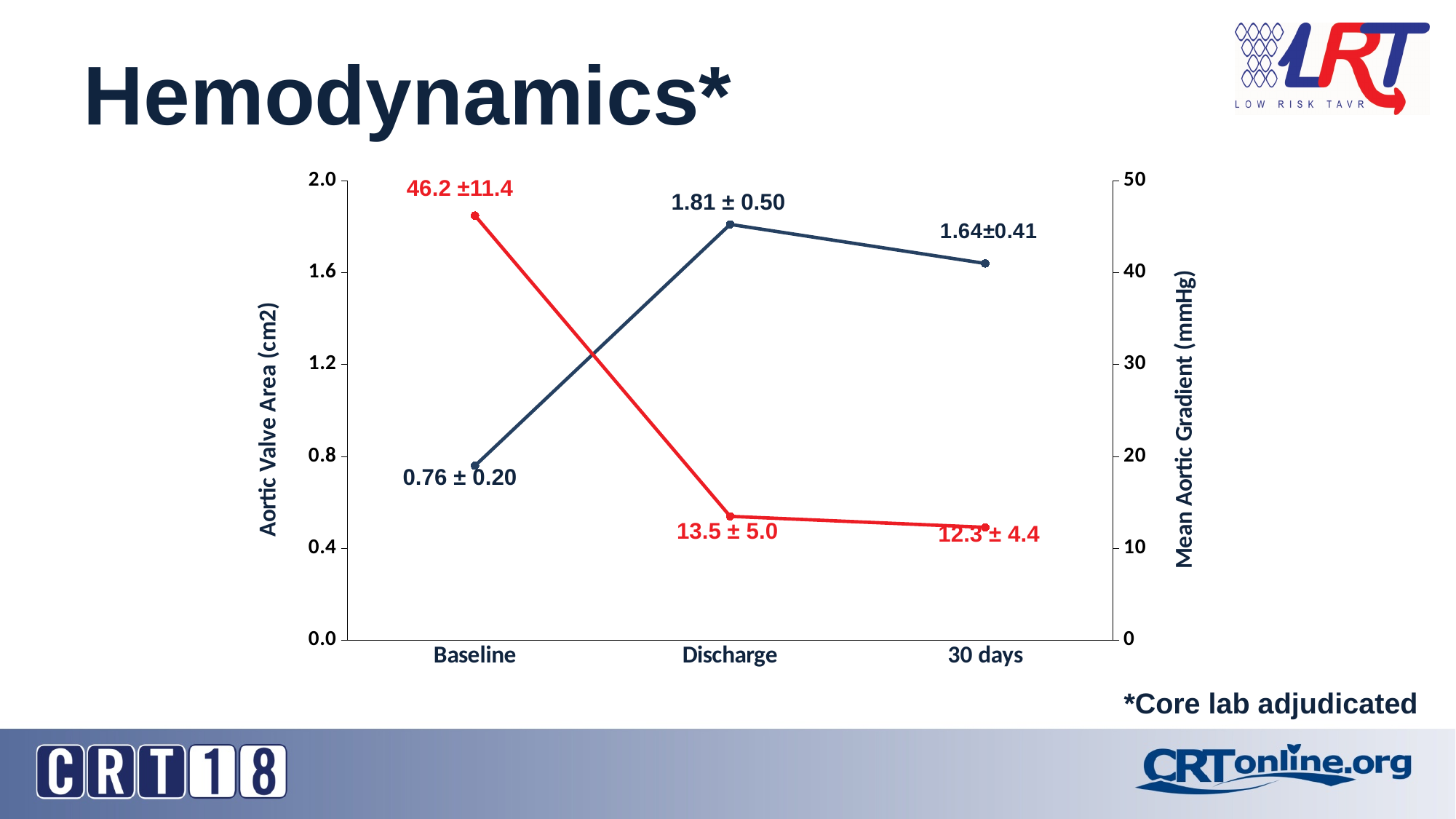
How many time points are plotted on the x axis? 3 What is the mean aortic gradient at 30 days? 12.3 ± 4.4 What is the aortic valve area at 30 days? 1.64±0.41 Does the mean aortic gradient rise or fall from baseline to 30 days? Fall At which time point is the aortic valve area lowest? Baseline At which time point is the mean aortic gradient highest? Baseline By how much does the mean aortic gradient (mean value) fall from baseline to discharge? 32.7 mmHg What is the aortic valve area at discharge? 1.81 ± 0.50 What is the mean aortic gradient at discharge? 13.5 ± 5.0 What is the mean aortic gradient at baseline? 46.2 ±11.4 What type of chart is shown on the slide? Line chart What is the aortic valve area at baseline? 0.76 ± 0.20